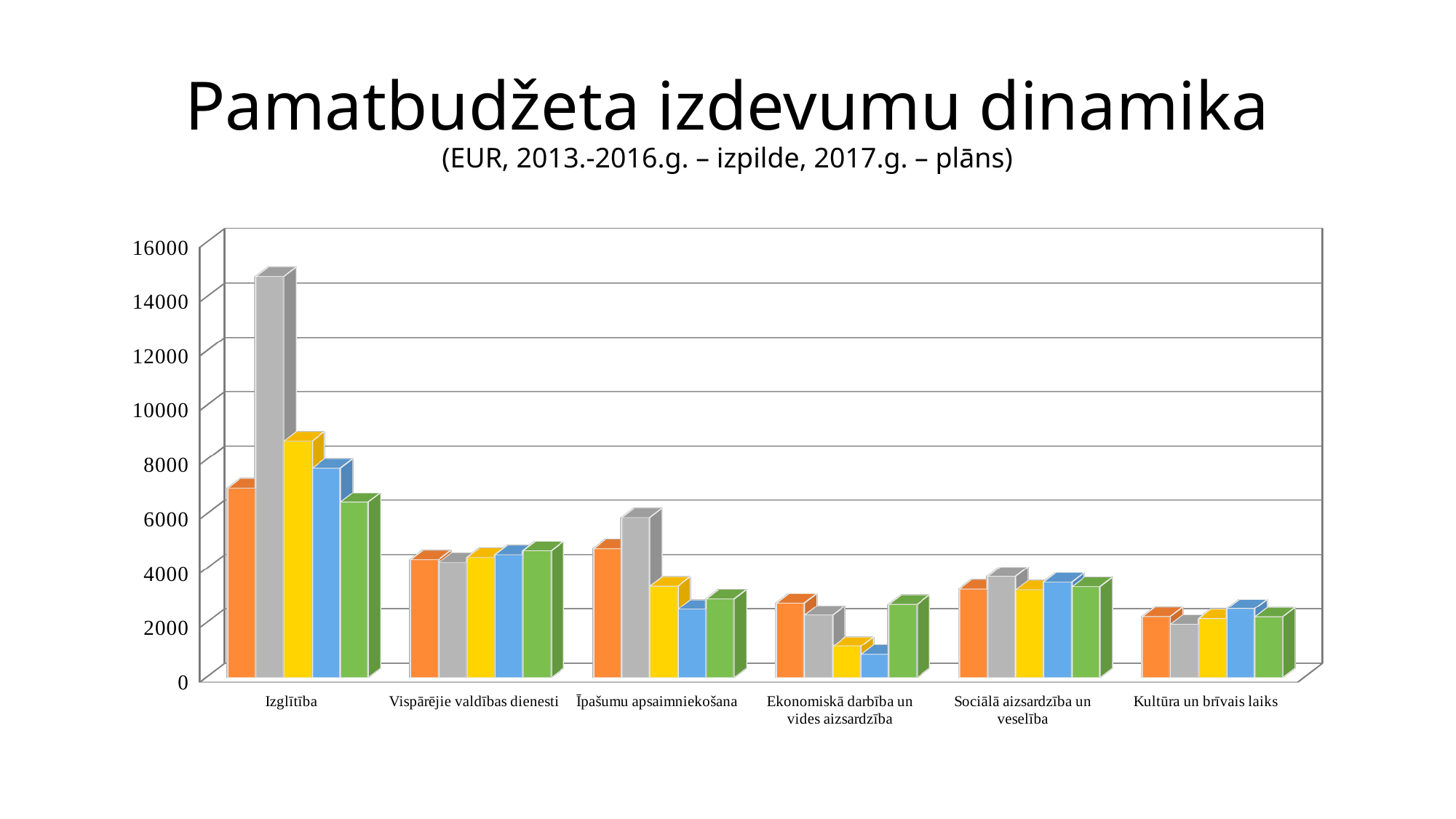
How many categories are shown on the x axis of the chart? 6 Is the value of the gray bar for Izglītība greater or less than 14000? greater What is the highest value shown on the vertical axis of the chart? 16000 Which category has the tallest bar in the chart? Izglītība Is the value of the gray bar for Īpašumu apsaimniekošana greater or less than 4000? greater What kind of chart is shown on the slide? bar chart Which is larger: the orange bar for Izglītība or the orange bar for Vispārējie valdības dienesti? Izglītība Which coloured bar is the tallest within the Izglītība category? gray What is the title of the chart on the slide? Pamatbudžeta izdevumu dinamika Is the value of the blue bar for Ekonomiskā darbība un vides aizsardzība greater or less than 2000? less Which coloured bar is the lowest within the Ekonomiskā darbība un vides aizsardzība category? blue